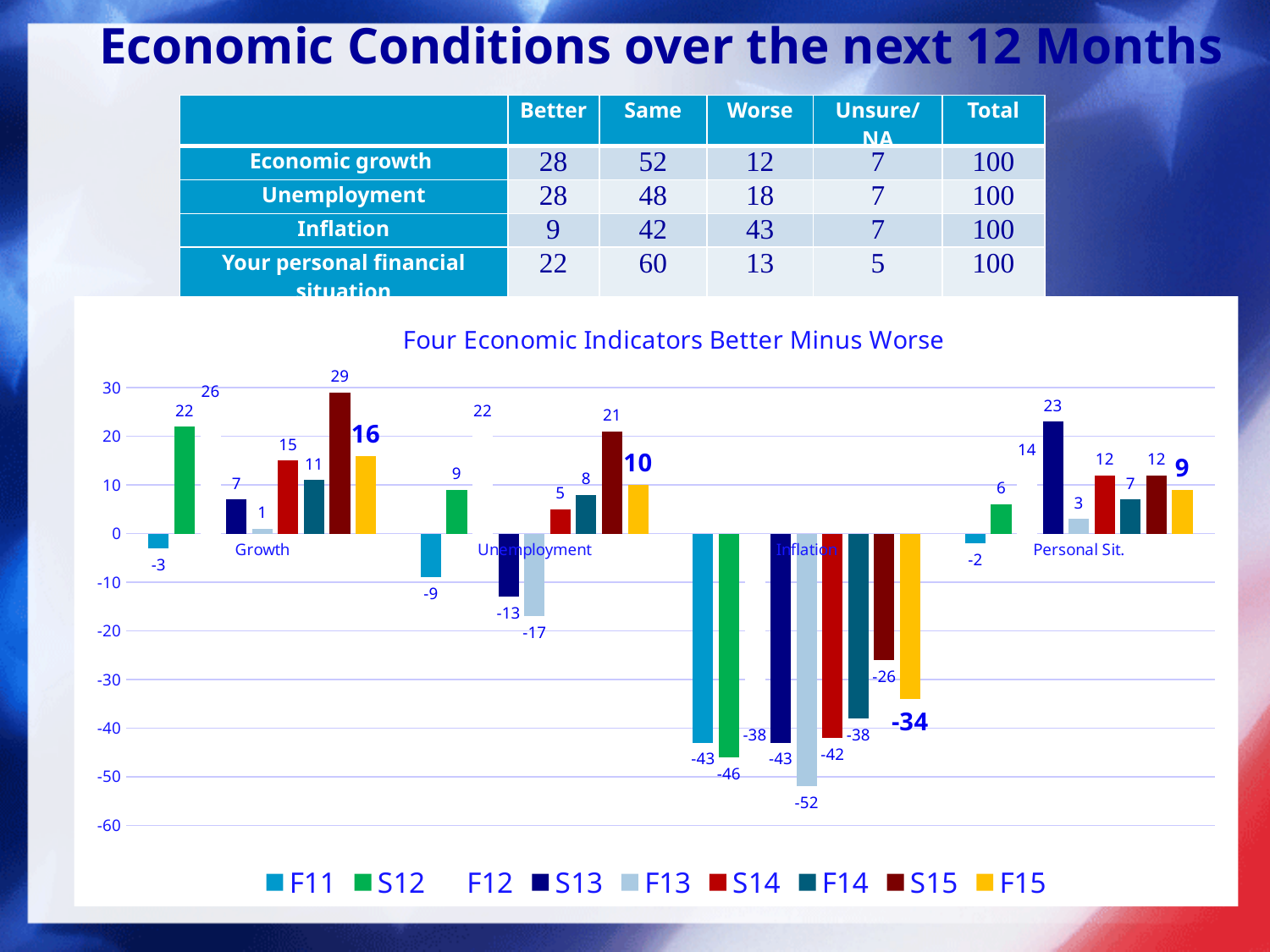
How many categories are shown along the x axis of the "Four Economic Indicators Better Minus Worse" chart? 4 What kind of chart is shown under the title "Four Economic Indicators Better Minus Worse"? bar chart How many series does the legend of the "Four Economic Indicators Better Minus Worse" chart list? 9 In the "Four Economic Indicators Better Minus Worse" chart, what is the S13 value for Personal Sit.? 23 In the "Four Economic Indicators Better Minus Worse" chart, what is the S15 value for Inflation? -26 In the "Four Economic Indicators Better Minus Worse" chart, which series has the highest value for Growth? S15 In the "Four Economic Indicators Better Minus Worse" chart, what is the F15 value for Growth? 16 In the "Four Economic Indicators Better Minus Worse" chart, what is the difference between the S15 and F15 values for Growth? 13 What is the title of the bar chart on the slide? Four Economic Indicators Better Minus Worse In the "Four Economic Indicators Better Minus Worse" chart, what is the F13 value for Inflation? -52 In the "Four Economic Indicators Better Minus Worse" chart, which is larger for Unemployment: the S15 value or the F15 value? S15 In the "Four Economic Indicators Better Minus Worse" chart, which series has the lowest value for Inflation? F13